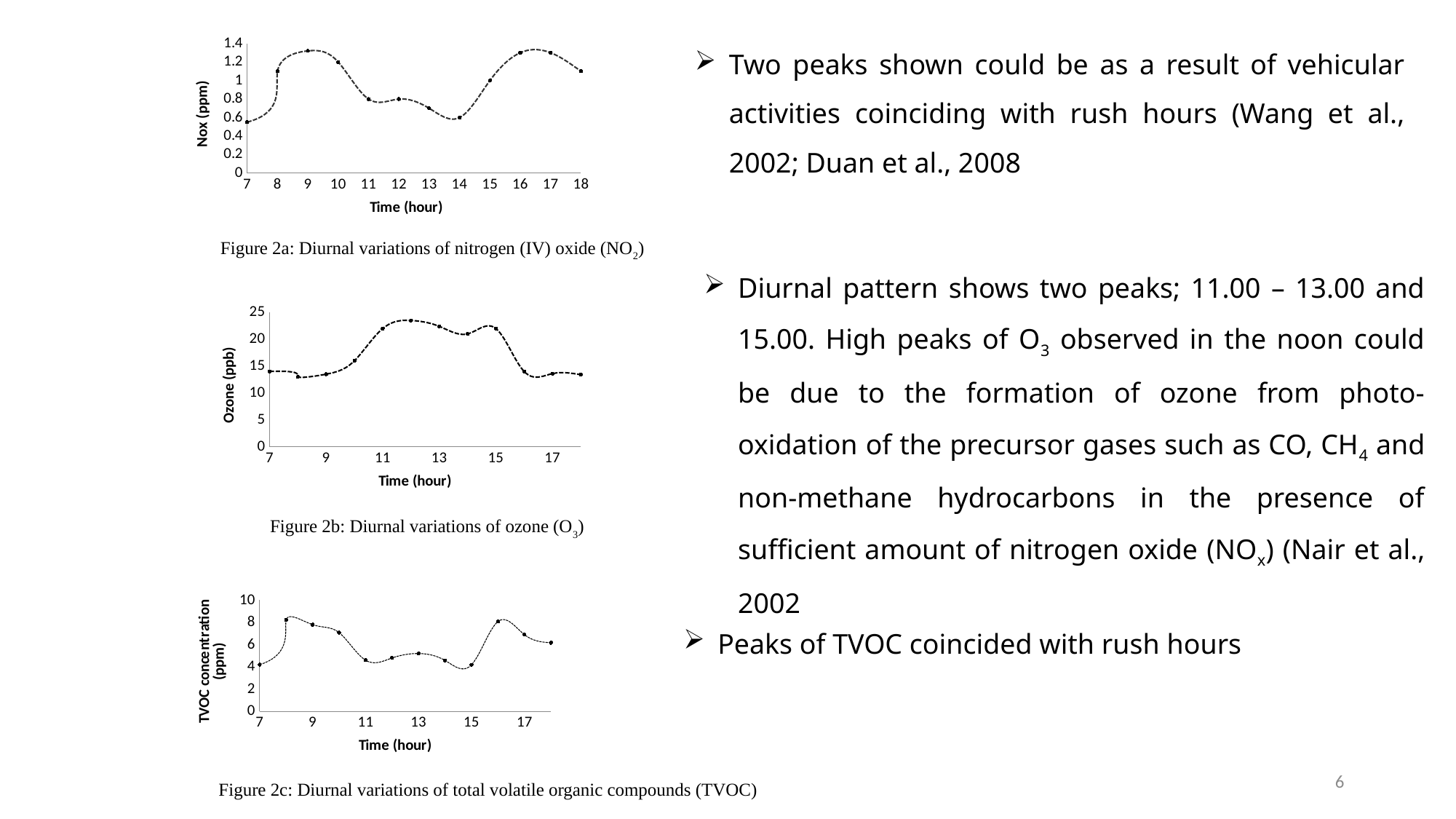
In Figure 2c (TVOC), which is larger, the value at 8 hours or the value at 11 hours? 8 hours What is the y-axis label of Figure 2b? Ozone (ppb) In Figure 2c (TVOC), is the value at 15 hours greater or less than 6? less In Figure 2b (Ozone), does the value rise or fall between 9 and 12 hours? rise In Figure 2c (TVOC), does the value rise or fall between 16 and 18 hours? fall In Figure 2a (NOx), is the value at 14 hours greater or less than 0.8? less In Figure 2b (Ozone), is the value at 8 hours greater or less than 15? less How many data points are plotted in Figure 2a (NOx)? 12 What type of chart is Figure 2a: Diurnal variations of nitrogen (IV) oxide (NO2)? Line chart In Figure 2a (NOx), does the value rise or fall between 9 and 11 hours? fall